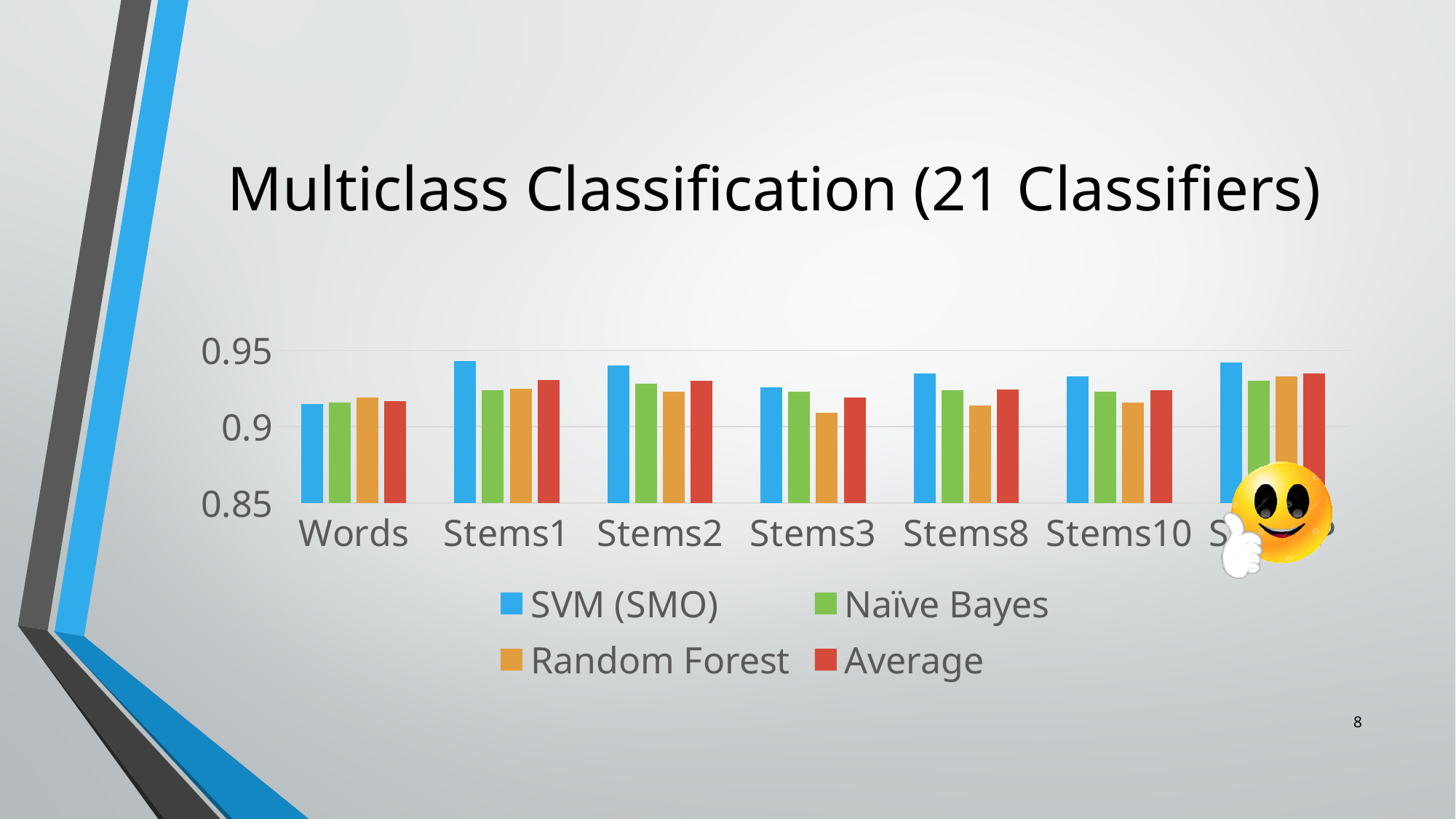
How many category groups are plotted along the x axis? 7 Is the SVM (SMO) value for Stems1 greater or less than 0.95? less What kind of chart is shown on the slide? bar chart Is the SVM (SMO) value for Words greater or less than 0.9? greater What is the title of the chart on the slide? Multiclass Classification (21 Classifiers) For Stems3, which series has the lowest value? Random Forest How many series does the legend list? 4 Which category has the lowest Random Forest value? Stems3 Which series is shown in blue in the legend? SVM (SMO) For Stems3, which is larger: the SVM (SMO) value or the Random Forest value? SVM (SMO) Which is larger: the SVM (SMO) value for Stems1 or the SVM (SMO) value for Words? Stems1 Is the Random Forest value for Stems3 greater or less than 0.9? greater